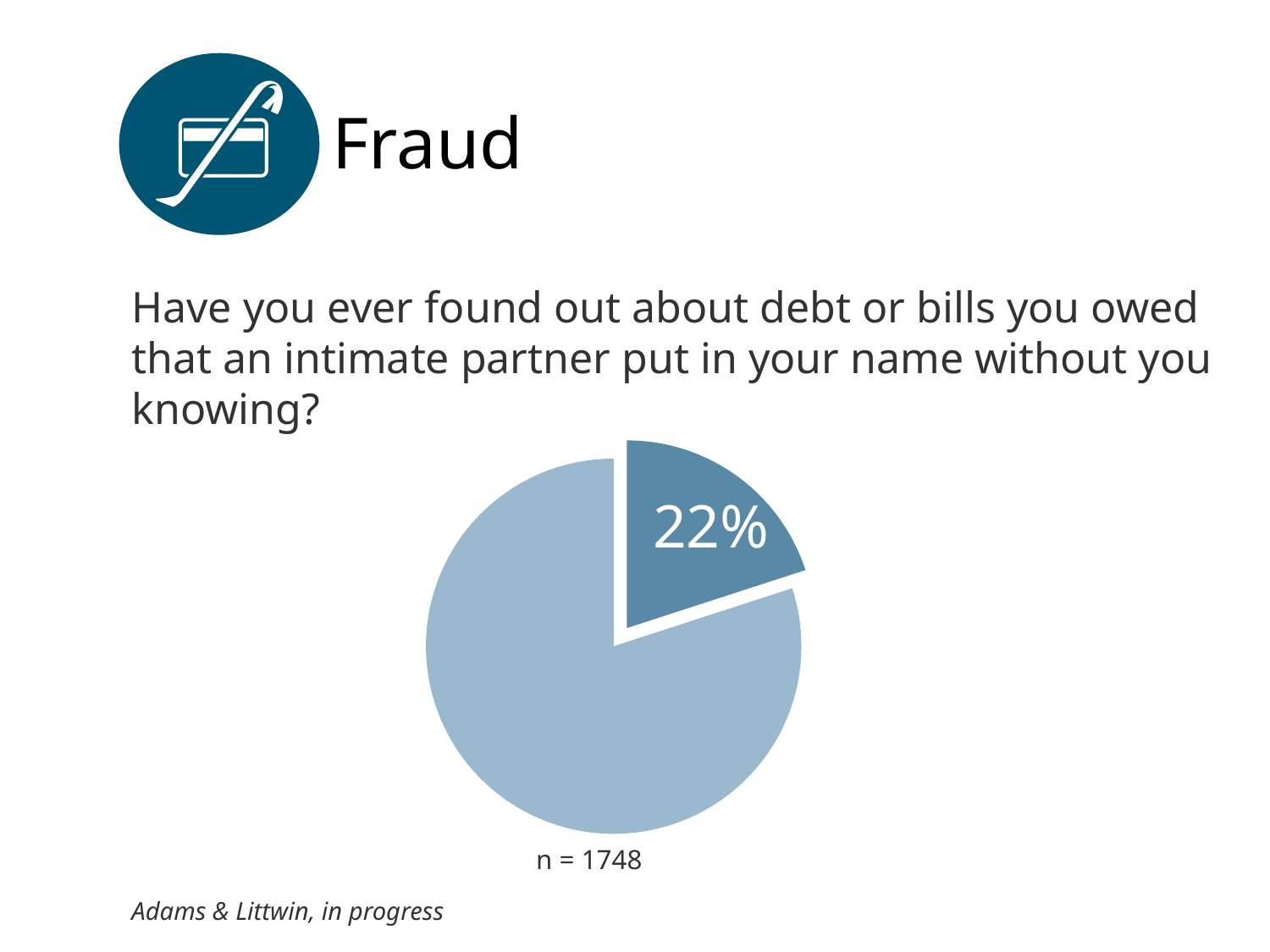
What percentage is shown on the exploded (darker blue) slice of the pie chart? 22% What sample size (n) is shown below the pie chart? n = 1748 What kind of chart is shown on the slide? pie chart What is the title shown at the top of the slide next to the icon? Fraud How many slices does the pie chart have? 2 Which slice of the pie chart is larger, the darker blue exploded slice or the lighter blue slice? the lighter blue slice Is the share of the exploded slice in the pie chart greater or less than 50%? less